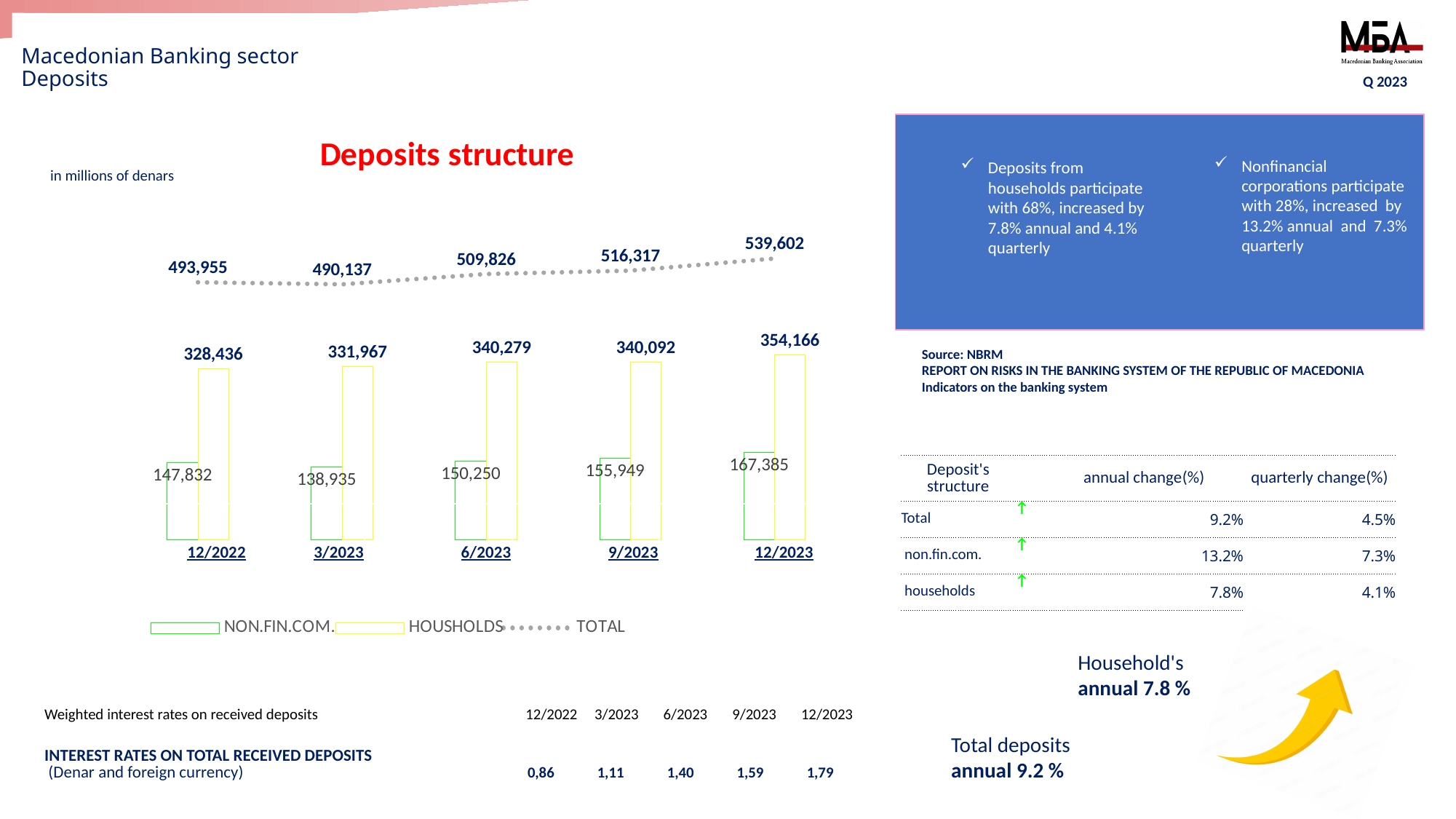
How many series does the legend of the Deposits structure chart list? 3 What is the difference between the TOTAL values for 12/2023 and 12/2022 in the Deposits structure chart? 45,647 What is the value of the TOTAL series for 12/2023 in the Deposits structure chart? 539,602 In which period is the HOUSHOLDS value highest in the Deposits structure chart? 12/2023 Which is larger in 9/2023 in the Deposits structure chart: the NON.FIN.COM. value or the HOUSHOLDS value? HOUSHOLDS By how much does the HOUSHOLDS value exceed the NON.FIN.COM. value in 12/2023 in the Deposits structure chart? 186,781 What is the HOUSHOLDS value for 6/2023 in the Deposits structure chart? 340,279 How many periods are shown on the x axis of the Deposits structure chart? 5 What is the NON.FIN.COM. value for 12/2022 in the Deposits structure chart? 147,832 In which period is the NON.FIN.COM. value lowest in the Deposits structure chart? 3/2023 In what units are the values in the Deposits structure chart expressed? in millions of denars Does the TOTAL series in the Deposits structure chart rise or fall from 12/2022 to 12/2023? rise